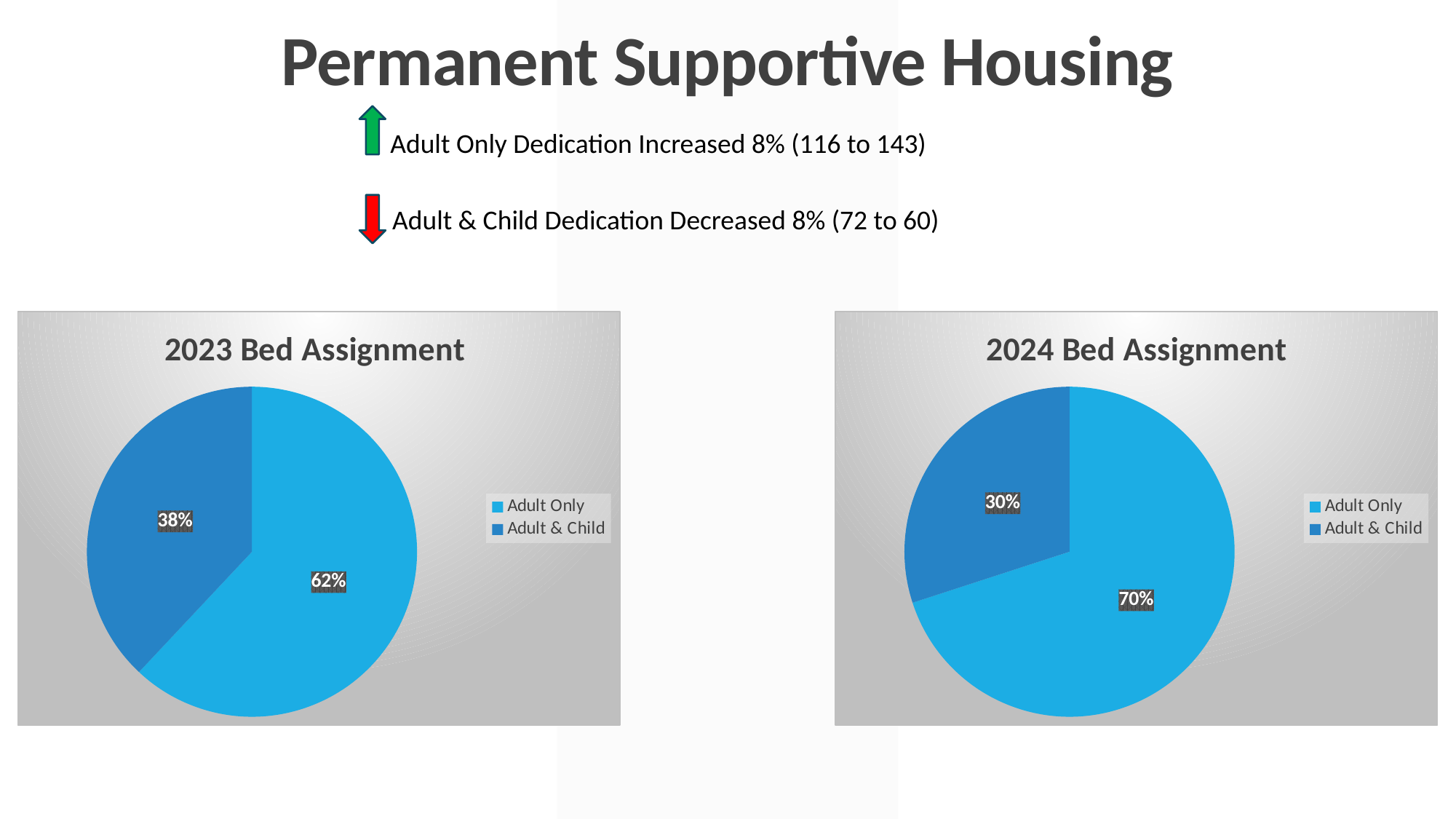
In the 2024 Bed Assignment chart, what share of the pie is Adult Only? 70% In the 2023 Bed Assignment chart, what share of the pie is Adult & Child? 38% Which is larger: the Adult Only share in the 2023 Bed Assignment chart or the Adult Only share in the 2024 Bed Assignment chart? 2024 Bed Assignment In the 2024 Bed Assignment chart, what share of the pie is Adult & Child? 30% In the 2023 Bed Assignment chart, what is the difference in percentage points between the Adult Only and Adult & Child slices? 24 What kind of chart is the 2023 Bed Assignment chart? Pie chart What are the two legend entries in the 2024 Bed Assignment chart? Adult Only, Adult & Child In the 2023 Bed Assignment chart, which category has the largest slice? Adult Only How many slices does the 2024 Bed Assignment pie chart have? 2 In the 2024 Bed Assignment chart, what is the difference in percentage points between the Adult Only and Adult & Child slices? 40 In the 2024 Bed Assignment chart, which category has the smallest slice? Adult & Child